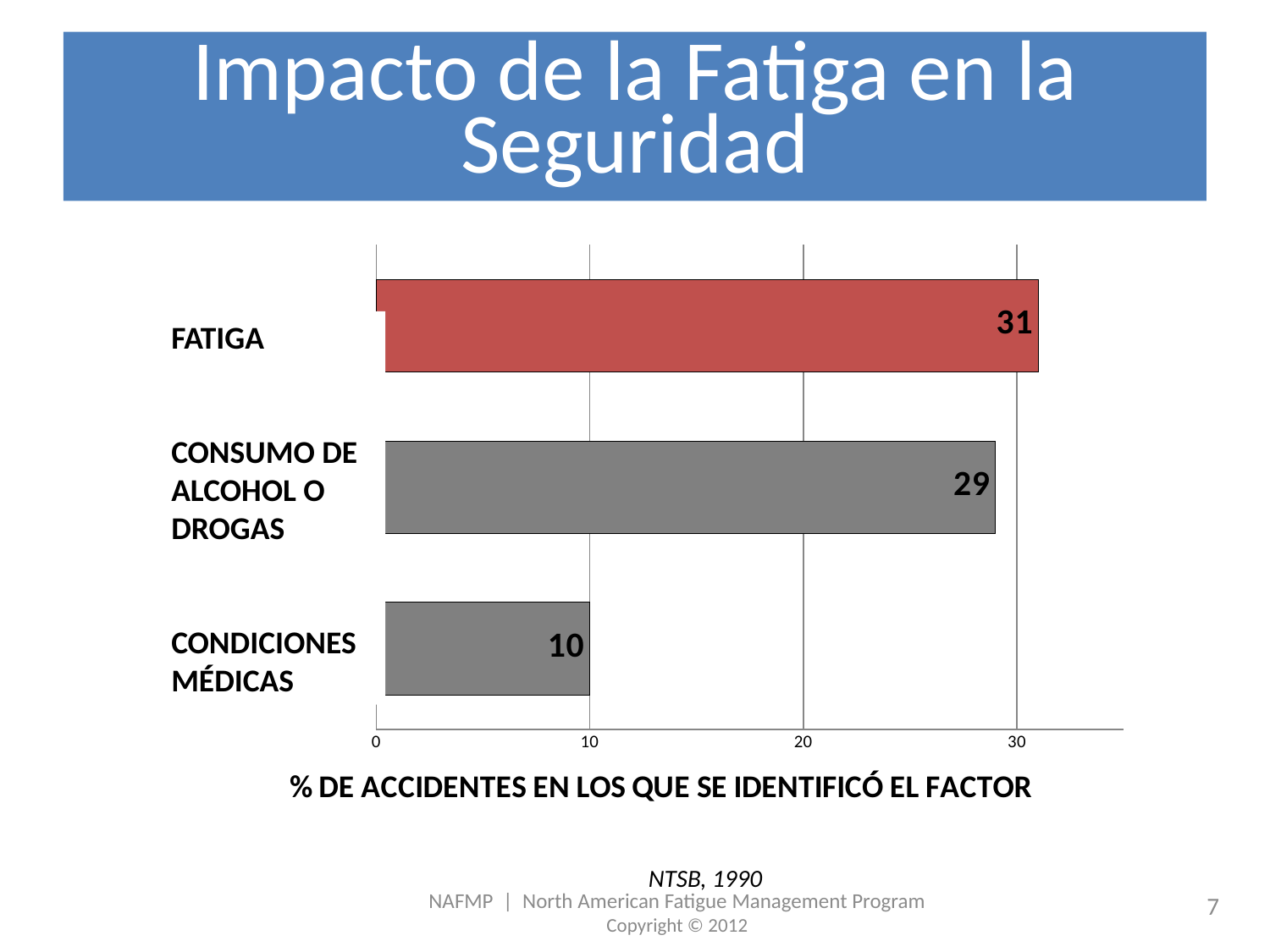
What is the value for FATIGA? 31 What is the label of the horizontal axis of the chart? % DE ACCIDENTES EN LOS QUE SE IDENTIFICÓ EL FACTOR What is the difference between the values for FATIGA and CONSUMO DE ALCOHOL O DROGAS? 2 Which is larger, the value for CONSUMO DE ALCOHOL O DROGAS or the value for CONDICIONES MÉDICAS? CONSUMO DE ALCOHOL O DROGAS What is the value for CONSUMO DE ALCOHOL O DROGAS? 29 Which category has the lowest value? CONDICIONES MÉDICAS Which category has the highest value? FATIGA Is the value for CONSUMO DE ALCOHOL O DROGAS greater or less than 20? greater What is the difference between the values for FATIGA and CONDICIONES MÉDICAS? 21 How many categories are shown in the chart? 3 What is the value for CONDICIONES MÉDICAS? 10 What kind of chart is shown on the slide? bar chart